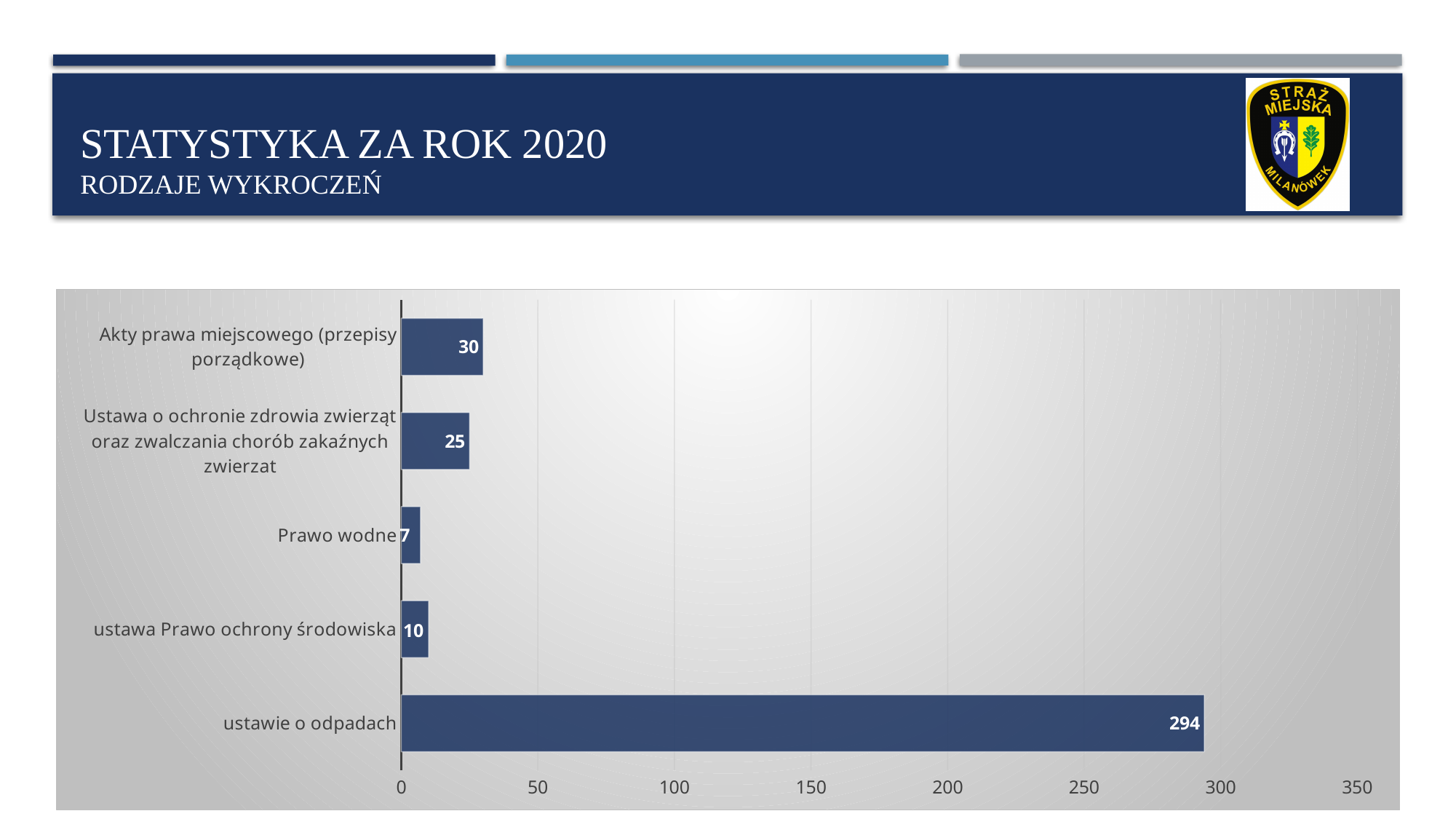
Is the value for "ustawie o odpadach" greater or less than 250? greater What is the subtitle of the slide below "STATYSTYKA ZA ROK 2020"? RODZAJE WYKROCZEŃ What kind of chart is shown on the slide? bar chart Which is larger: the value for "Ustawa o ochronie zdrowia zwierząt oraz zwalczania chorób zakaźnych zwierzat" or for "ustawa Prawo ochrony środowiska"? Ustawa o ochronie zdrowia zwierząt oraz zwalczania chorób zakaźnych zwierzat How many categories are shown in the chart? 5 Which category has the lowest value? Prawo wodne What is the value for "ustawa Prawo ochrony środowiska"? 10 What is the value for "Akty prawa miejscowego (przepisy porządkowe)"? 30 What is the value for "Prawo wodne"? 7 Which category has the highest value? ustawie o odpadach What is the value for "ustawie o odpadach"? 294 What is the difference between the values for "ustawie o odpadach" and "Akty prawa miejscowego (przepisy porządkowe)"? 264